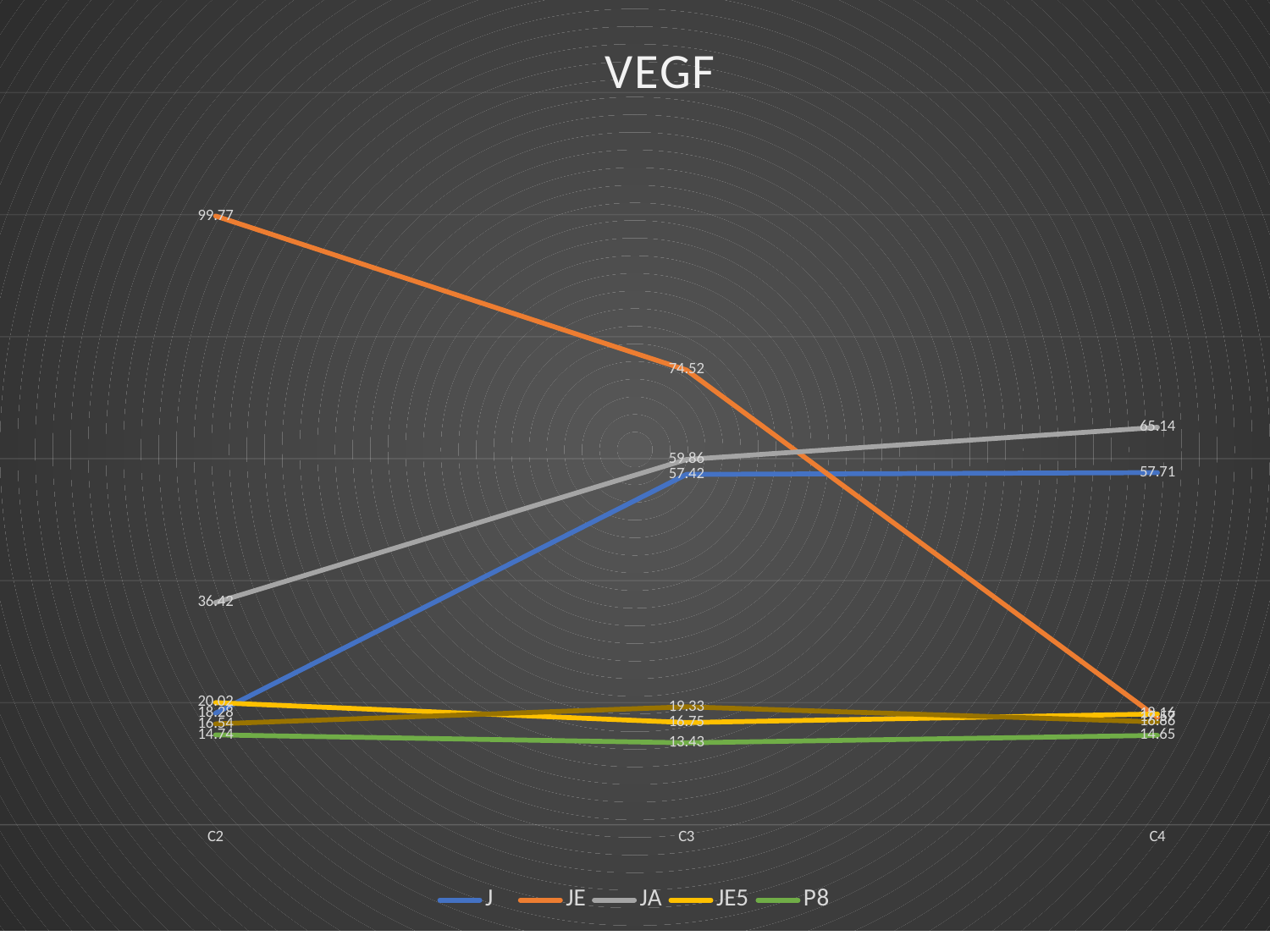
How many categories are shown on the x axis? 3 What is the value of JA at C4? 65.14 Does the JA series rise or fall from C2 to C4? rise What is the value of P8 at C3? 13.43 What is the title of the chart? VEGF What type of chart is shown on the slide? line chart Which series has the lowest value at C3? P8 Which series has the highest value at C2? JE How many series does the legend list? 5 What is the value of JE at C2? 99.77 What is the value of J at C3? 57.42 What is the difference between JE's value at C2 and at C3? 25.25